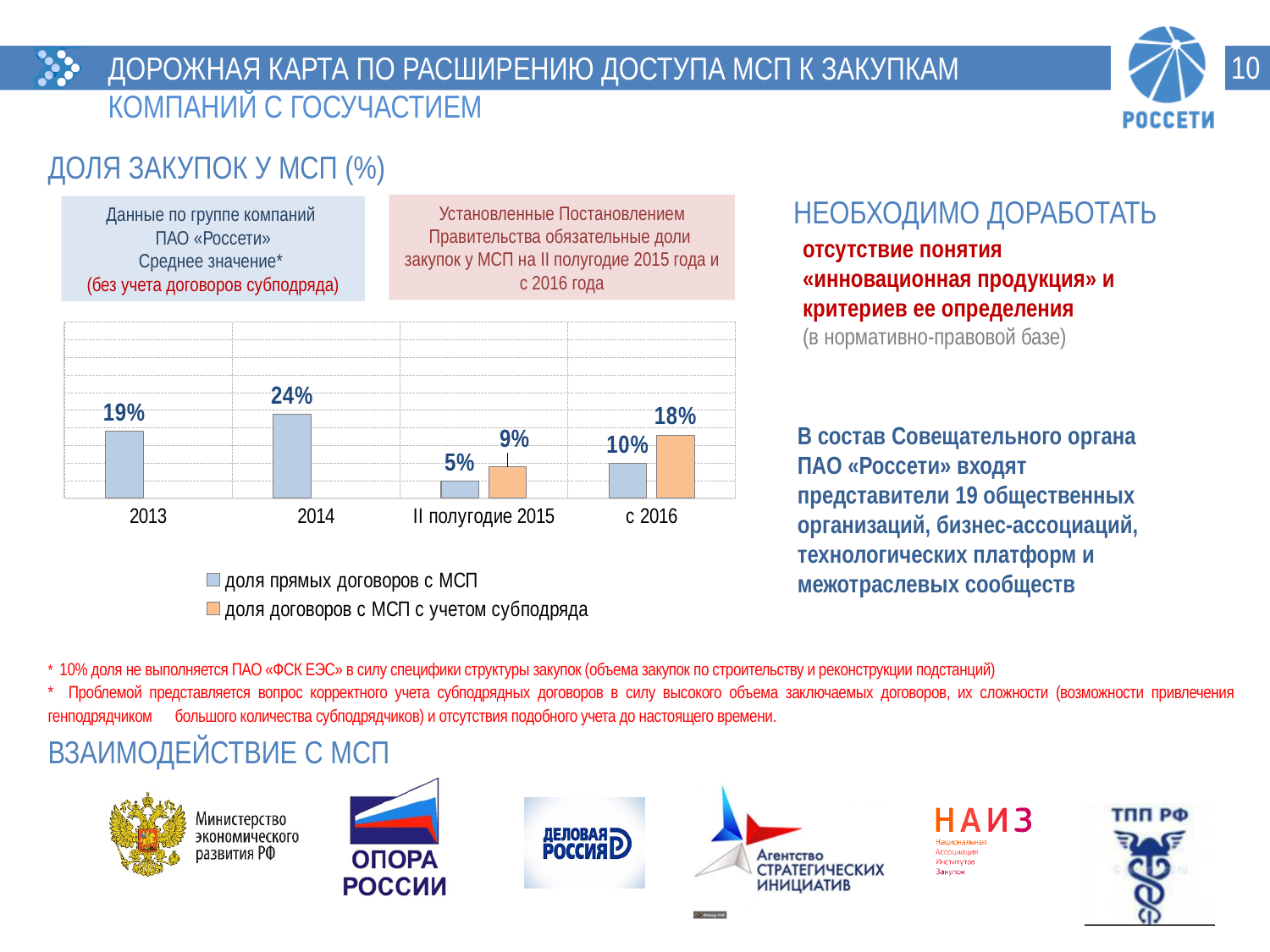
For «с 2016», which is larger: «доля прямых договоров с МСП» or «доля договоров с МСП с учетом субподряда»? доля договоров с МСП с учетом субподряда What is the title of the chart section on the slide? ДОЛЯ ЗАКУПОК У МСП (%) Which category has the lowest value for «доля прямых договоров с МСП»? II полугодие 2015 How many categories are shown on the x axis of the chart? 4 What is the value of «доля прямых договоров с МСП» for 2013? 19% What kind of chart is shown on the slide? bar chart What is the value of «доля договоров с МСП с учетом субподряда» for «с 2016»? 18% What is the value of «доля прямых договоров с МСП» for «II полугодие 2015»? 5% How many series does the chart legend list? 2 What is the difference between the 2014 and 2013 values of «доля прямых договоров с МСП»? 5% Which category has the highest value for «доля прямых договоров с МСП»? 2014 What is the value of «доля прямых договоров с МСП» for 2014? 24%